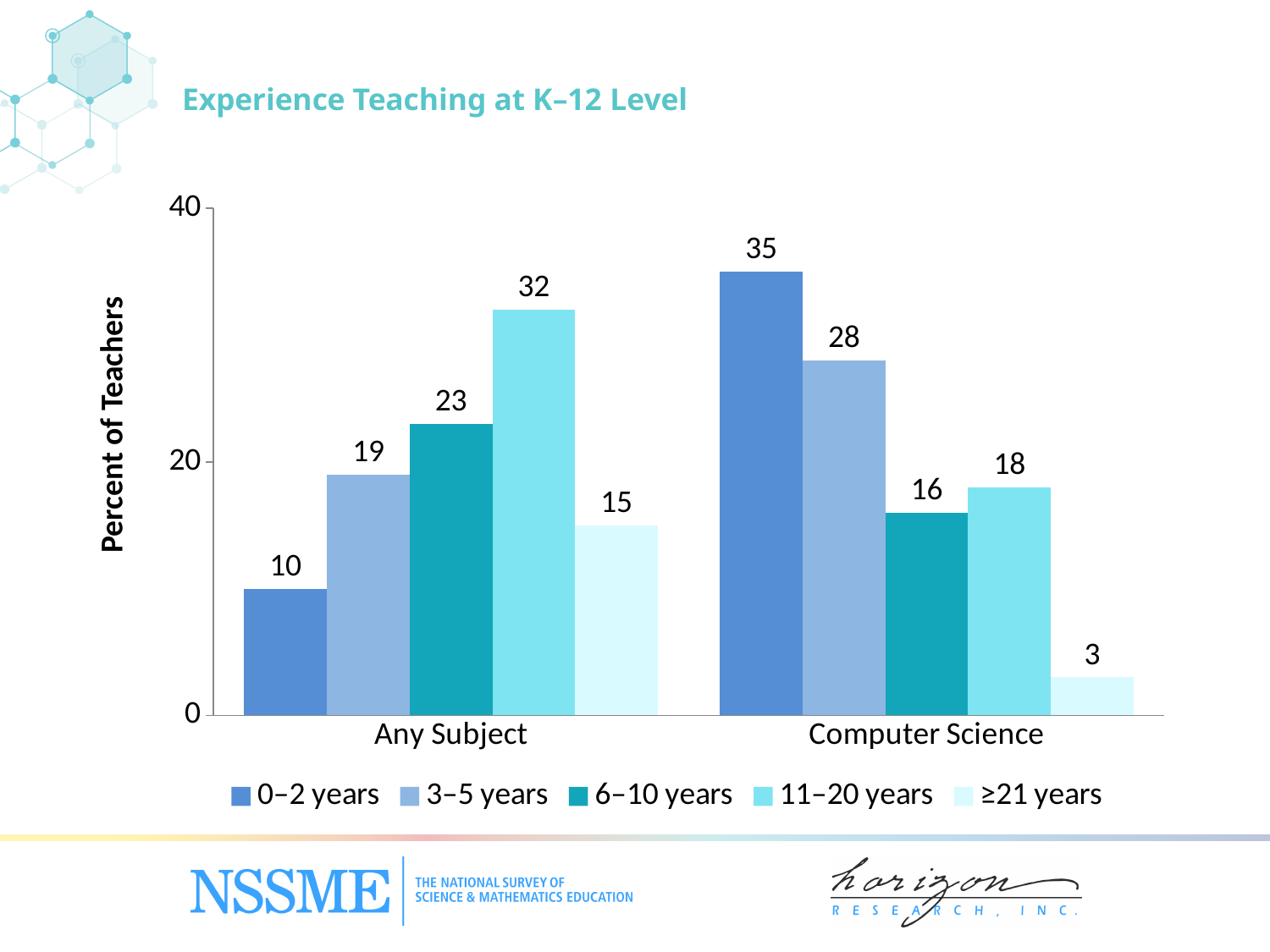
Is the value for 6–10 years in Any Subject greater or less than 20? greater What percent of teachers have 0–2 years of experience teaching Computer Science? 35 Which is larger: the 3–5 years value for Any Subject or for Computer Science? Computer Science How many series does the legend list? 5 What is the difference between the 0–2 years values for Computer Science and Any Subject? 25 What is the value for ≥21 years in the Computer Science category? 3 How many categories are shown on the x axis? 2 What is the label of the y axis? Percent of Teachers Which experience range has the lowest value in the Computer Science category? ≥21 years What percent of teachers have 11–20 years of experience teaching Any Subject? 32 What kind of chart is shown on the slide? Bar chart Which experience range has the highest value in the Any Subject category? 11–20 years